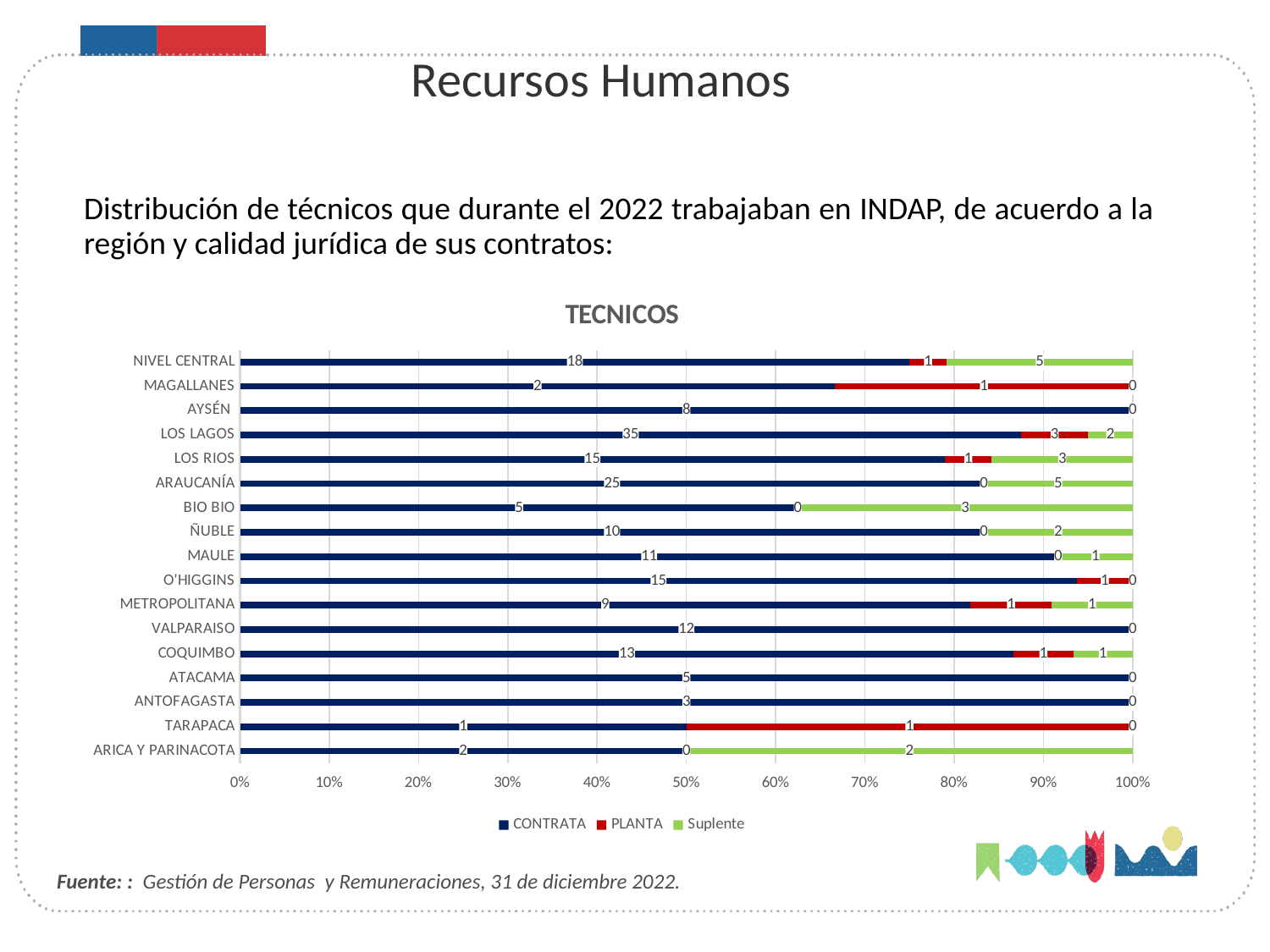
In the TECNICOS chart, what is the Suplente value for NIVEL CENTRAL? 5 What kind of chart is the TECNICOS chart? Stacked bar chart How many regions (categories) are shown in the TECNICOS chart? 17 In the TECNICOS chart, what is the CONTRATA value for ARAUCANÍA? 25 In the TECNICOS chart, what is the PLANTA value for LOS RIOS? 1 In the TECNICOS chart, which has a larger CONTRATA value, NIVEL CENTRAL or COQUIMBO? NIVEL CENTRAL How many series does the legend of the TECNICOS chart list? 3 In the TECNICOS chart, what is the CONTRATA value for LOS LAGOS? 35 In the TECNICOS chart, which region has the lowest CONTRATA value? TARAPACA In the TECNICOS chart, what is the difference between the CONTRATA values for LOS LAGOS and ARAUCANÍA? 10 In the TECNICOS chart, what is the total of the three values for NIVEL CENTRAL? 24 In the TECNICOS chart, which region has the highest CONTRATA value? LOS LAGOS